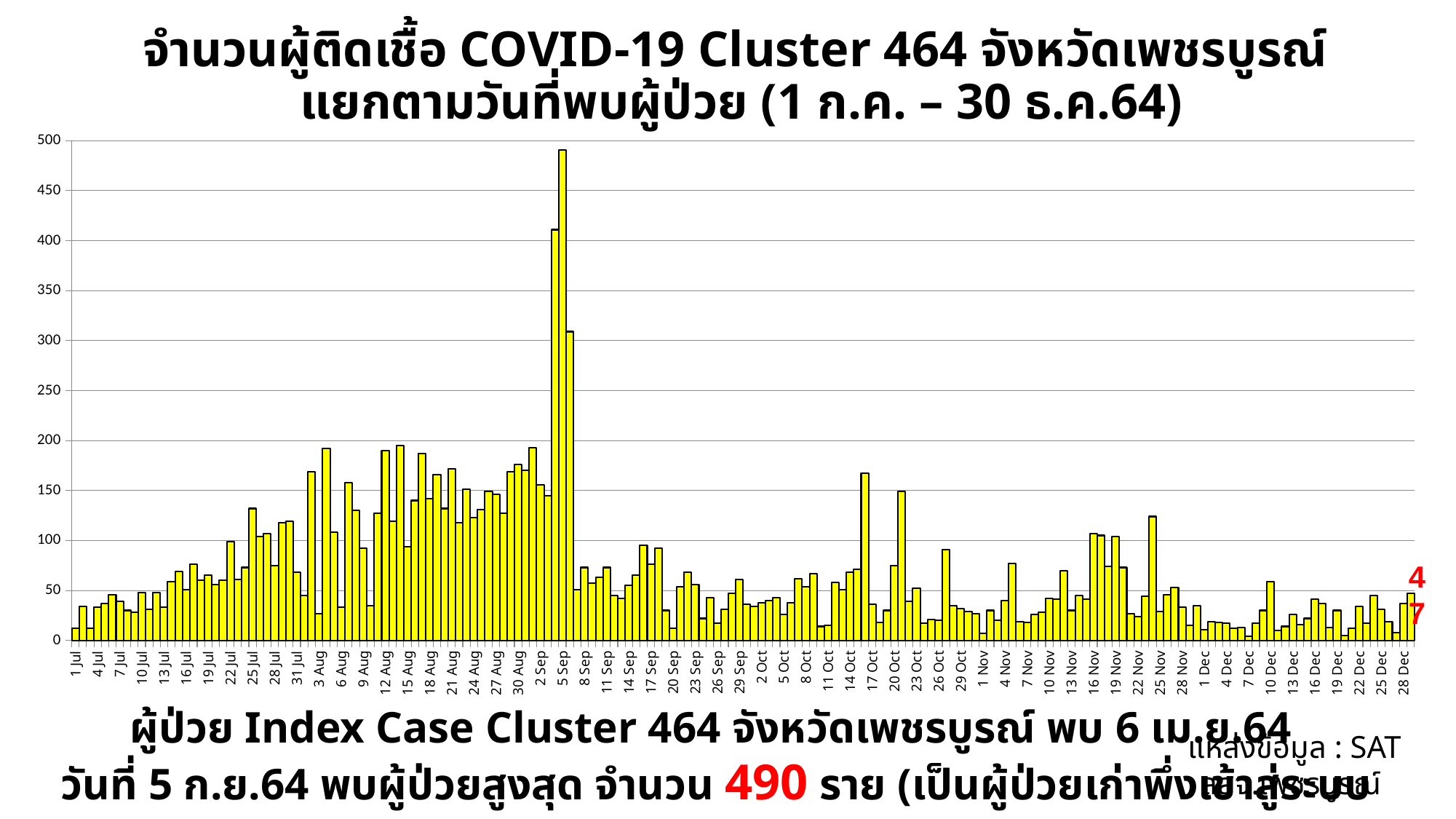
What is the number of cases on 5 Sep, the peak day? 490 Which date has the larger value, 5 Sep or 1 Jul? 5 Sep Is the value for 5 Sep greater or less than 450? greater Is the value for 1 Nov greater or less than 50? less What colour are the bars in the chart? yellow On which date does the chart reach its highest value? 5 Sep Is the value for 7 Dec greater or less than 50? less What is the highest value shown on the vertical axis? 500 What kind of chart is shown on the slide? bar chart Do the values generally rise or fall from 5 Sep to 8 Sep? fall